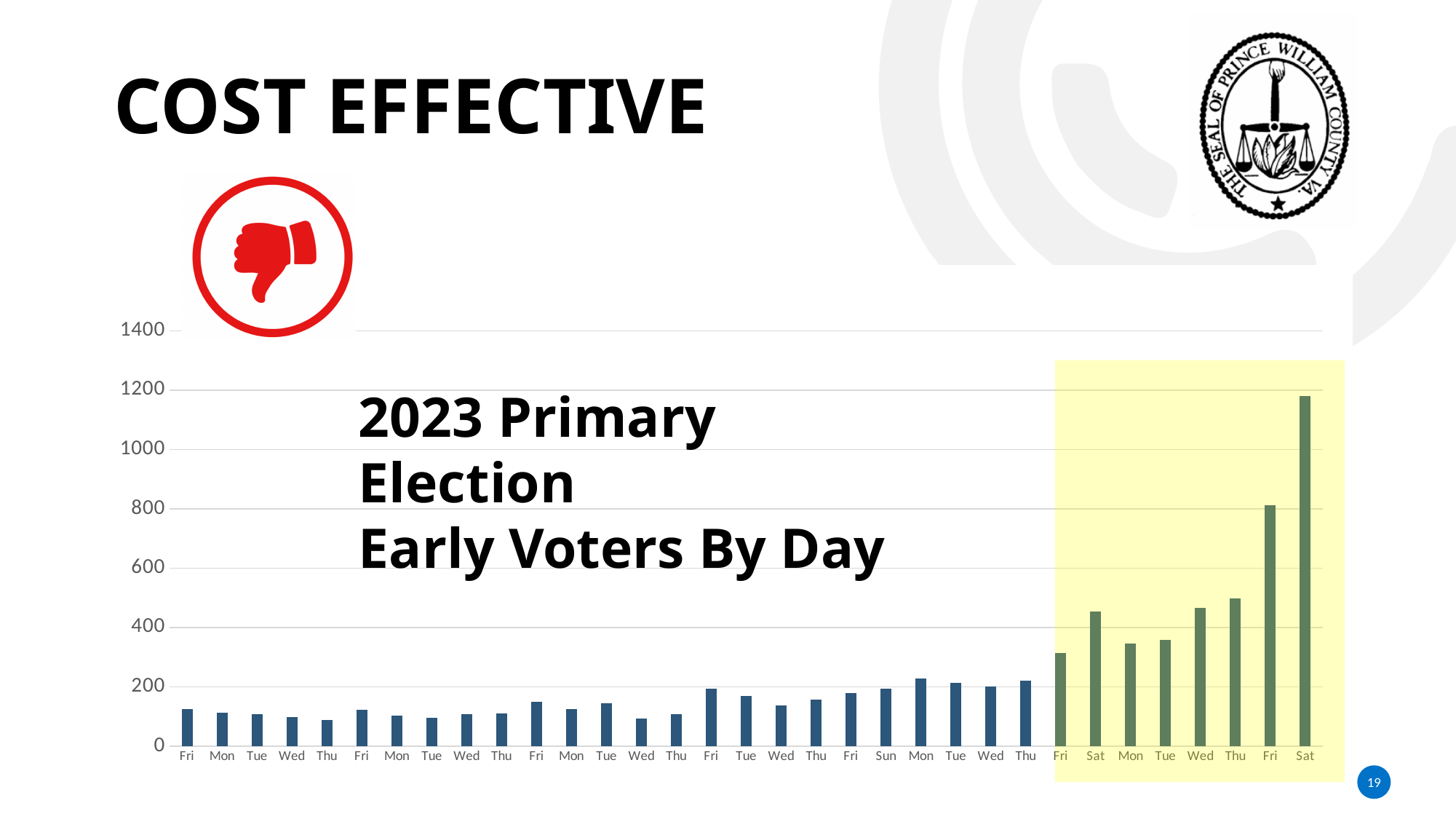
What type of chart is shown on the slide? bar chart Do the values generally rise or fall moving from left to right along the x axis? rise Is the value for the final Sat greater or less than 1000? greater Which is larger, the value for the first Sat or the value for Sun? the first Sat What is the title of the chart? 2023 Primary Election Early Voters By Day Is the value for Sun greater or less than 400? less Which is larger, the value for the final Sat or the value for the final Fri? the final Sat Is the value for the final Fri greater or less than 600? greater What is the highest value shown on the y axis? 1400 How many bars (days) are plotted in the chart? 33 Which day has the highest number of early voters? the final Sat